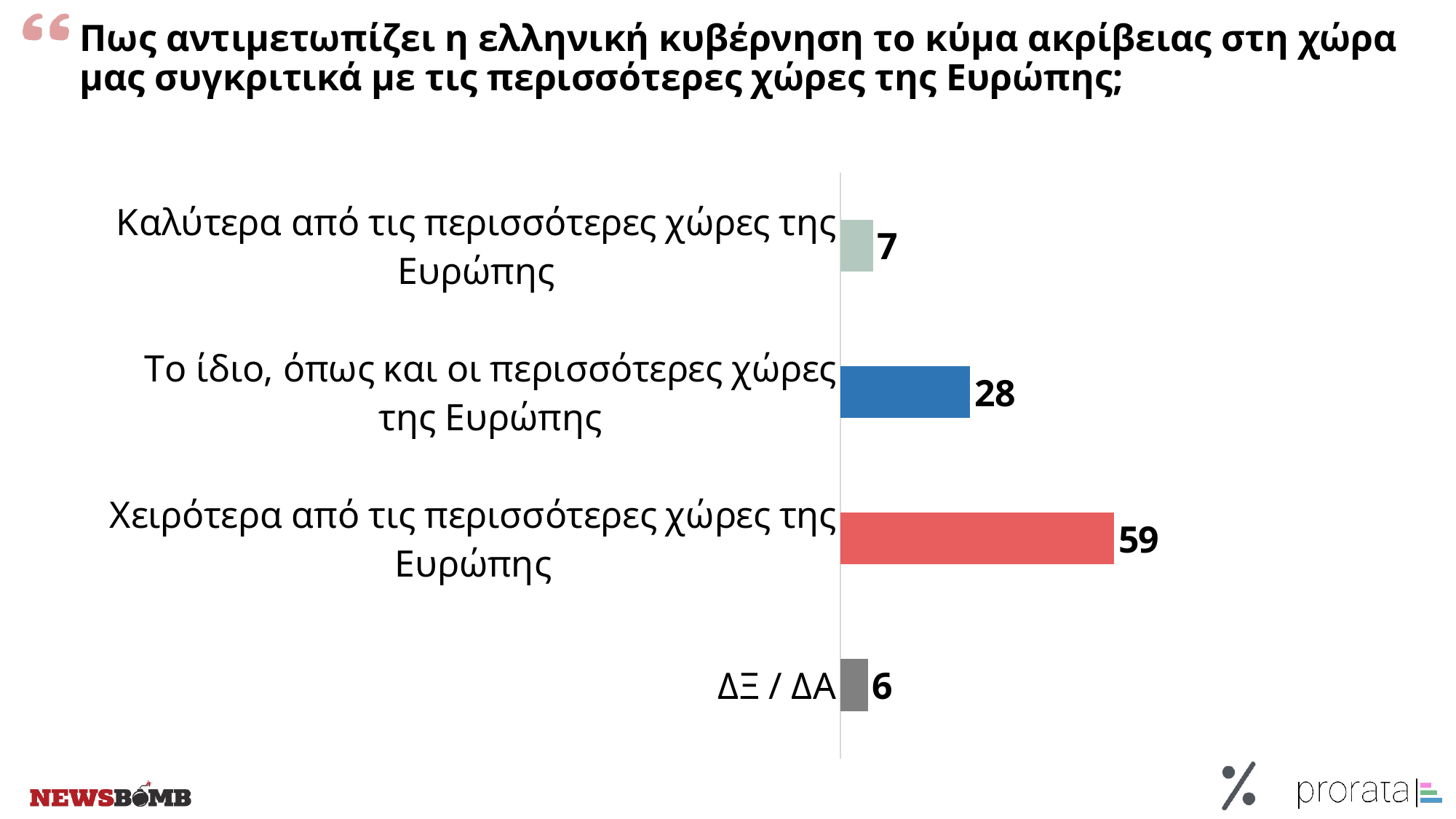
What kind of chart is shown on the slide? Bar chart Which is larger: the value for "Το ίδιο, όπως και οι περισσότερες χώρες της Ευρώπης" or the value for "Καλύτερα από τις περισσότερες χώρες της Ευρώπης"? Το ίδιο, όπως και οι περισσότερες χώρες της Ευρώπης What colour is the bar for "Χειρότερα από τις περισσότερες χώρες της Ευρώπης"? Red What is the value for "Καλύτερα από τις περισσότερες χώρες της Ευρώπης"? 7 What is the value for "Το ίδιο, όπως και οι περισσότερες χώρες της Ευρώπης"? 28 Which category has the highest value? Χειρότερα από τις περισσότερες χώρες της Ευρώπης How many categories are shown in the chart? 4 Which category has the lowest value? ΔΞ / ΔΑ What is the value for "ΔΞ / ΔΑ"? 6 What is the difference between the values for "Χειρότερα από τις περισσότερες χώρες της Ευρώπης" and "Το ίδιο, όπως και οι περισσότερες χώρες της Ευρώπης"? 31 What is the value for "Χειρότερα από τις περισσότερες χώρες της Ευρώπης"? 59 What is the difference between the values for "Καλύτερα από τις περισσότερες χώρες της Ευρώπης" and "ΔΞ / ΔΑ"? 1